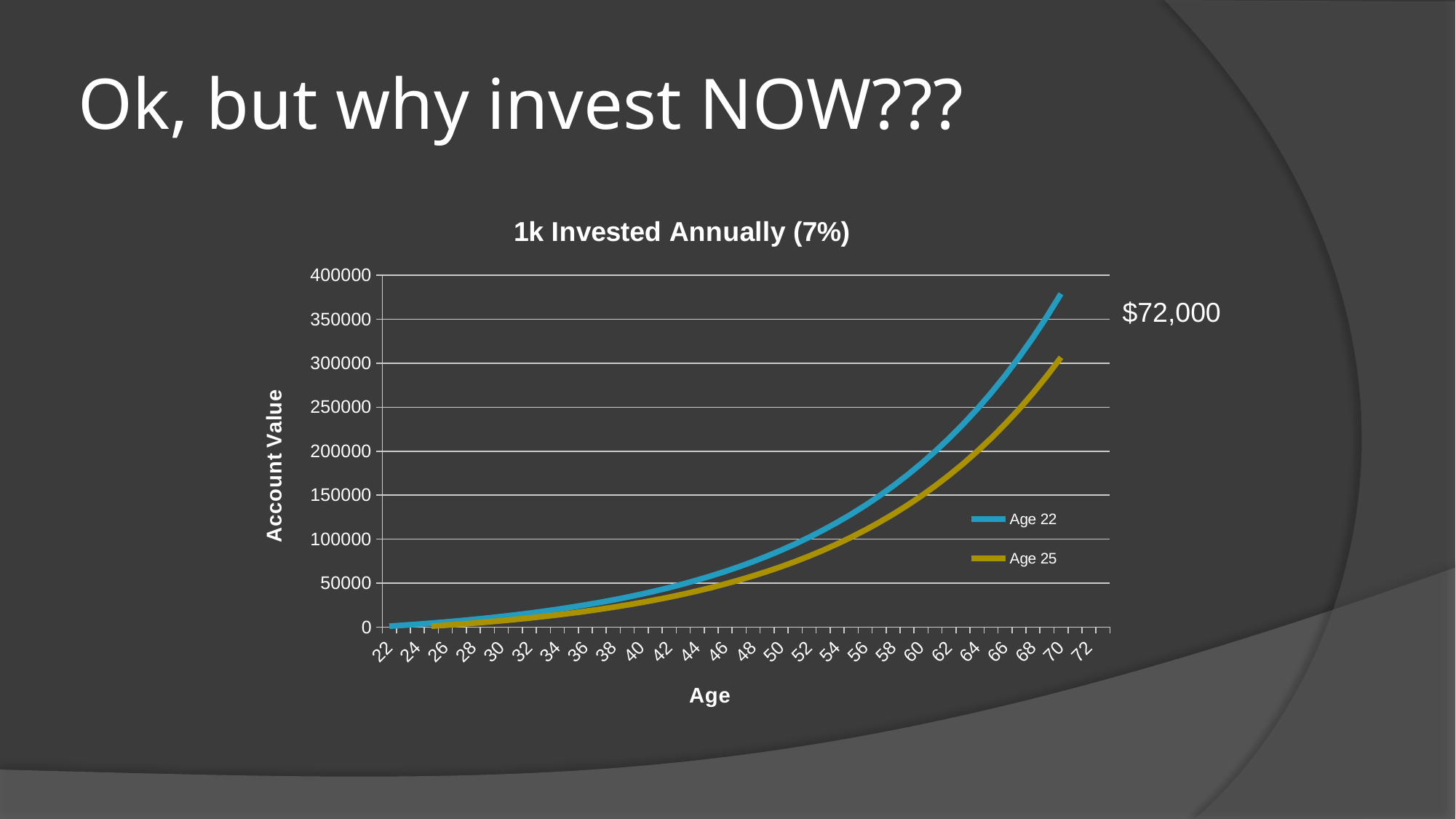
Which series is drawn in blue? Age 22 How many age labels are shown along the x axis? 26 How many series does the chart's legend list? 2 Is the account value for the Age 22 series at age 64 greater or less than 200000? greater Do the account values rise or fall as age increases along the x axis? rise Is the account value for the Age 22 series at age 50 greater or less than 100000? less What is the title of the chart? 1k Invested Annually (7%) Is the account value for the Age 22 series at age 40 greater or less than 50000? less At age 70, which series has the higher account value, Age 22 or Age 25? Age 22 What type of chart is shown on the slide? line chart